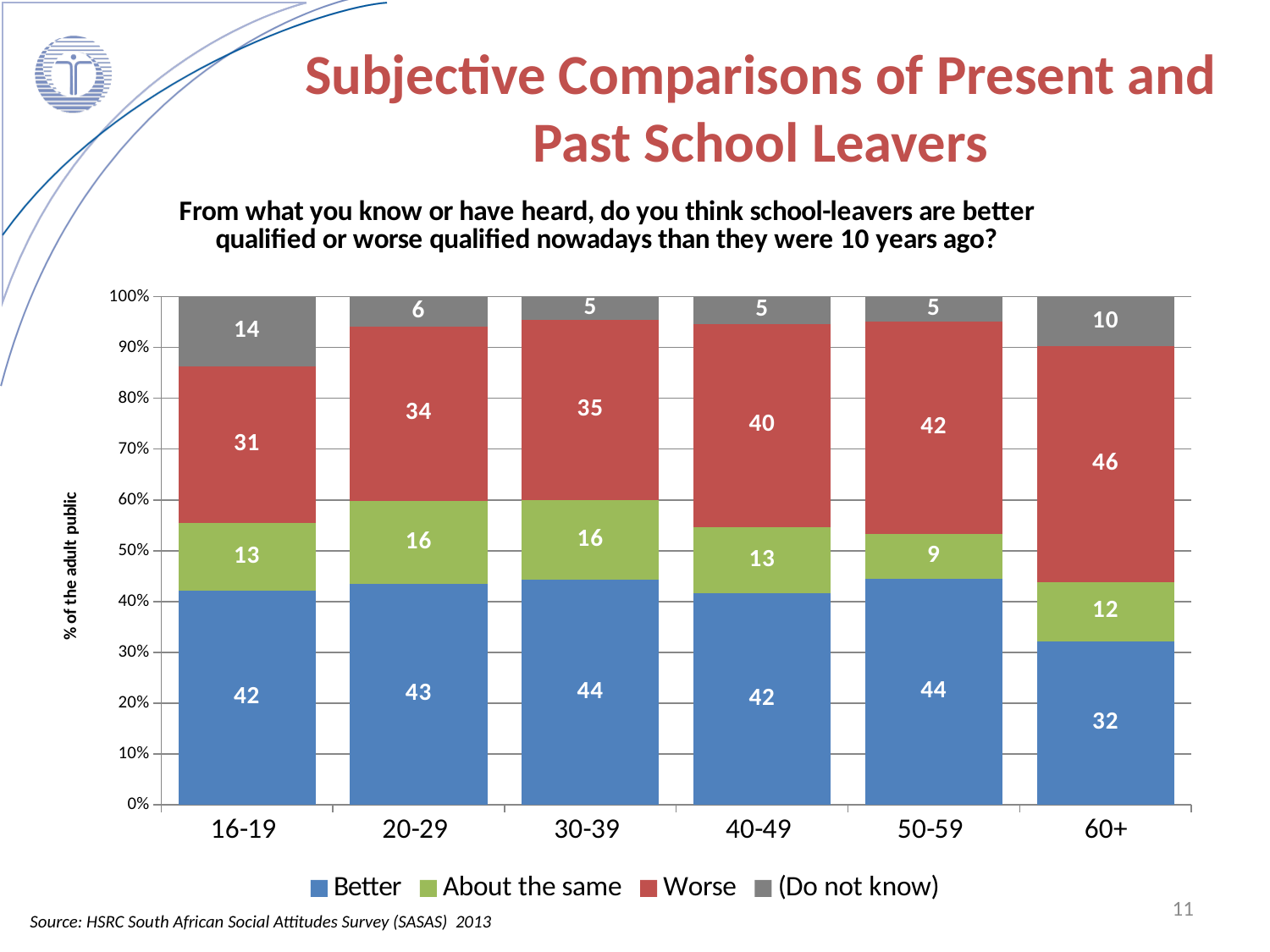
What is the difference between the "Worse" values for the 60+ and 16-19 age groups? 15 What is the value for "(Do not know)" in the 20-29 age group? 6 How many age groups are shown on the x axis? 6 Which is larger: the "Better" value for 30-39 or the "Better" value for 60+? 30-39 What is the value for "About the same" in the 50-59 age group? 9 What is the value for "Better" in the 16-19 age group? 42 Which age group has the highest value for "Worse"? 60+ Which age group has the lowest value for "Better"? 60+ What is the label of the y axis? % of the adult public What kind of chart is shown on the slide? Stacked bar chart What is the value for "Worse" in the 60+ age group? 46 How many series does the legend list? 4